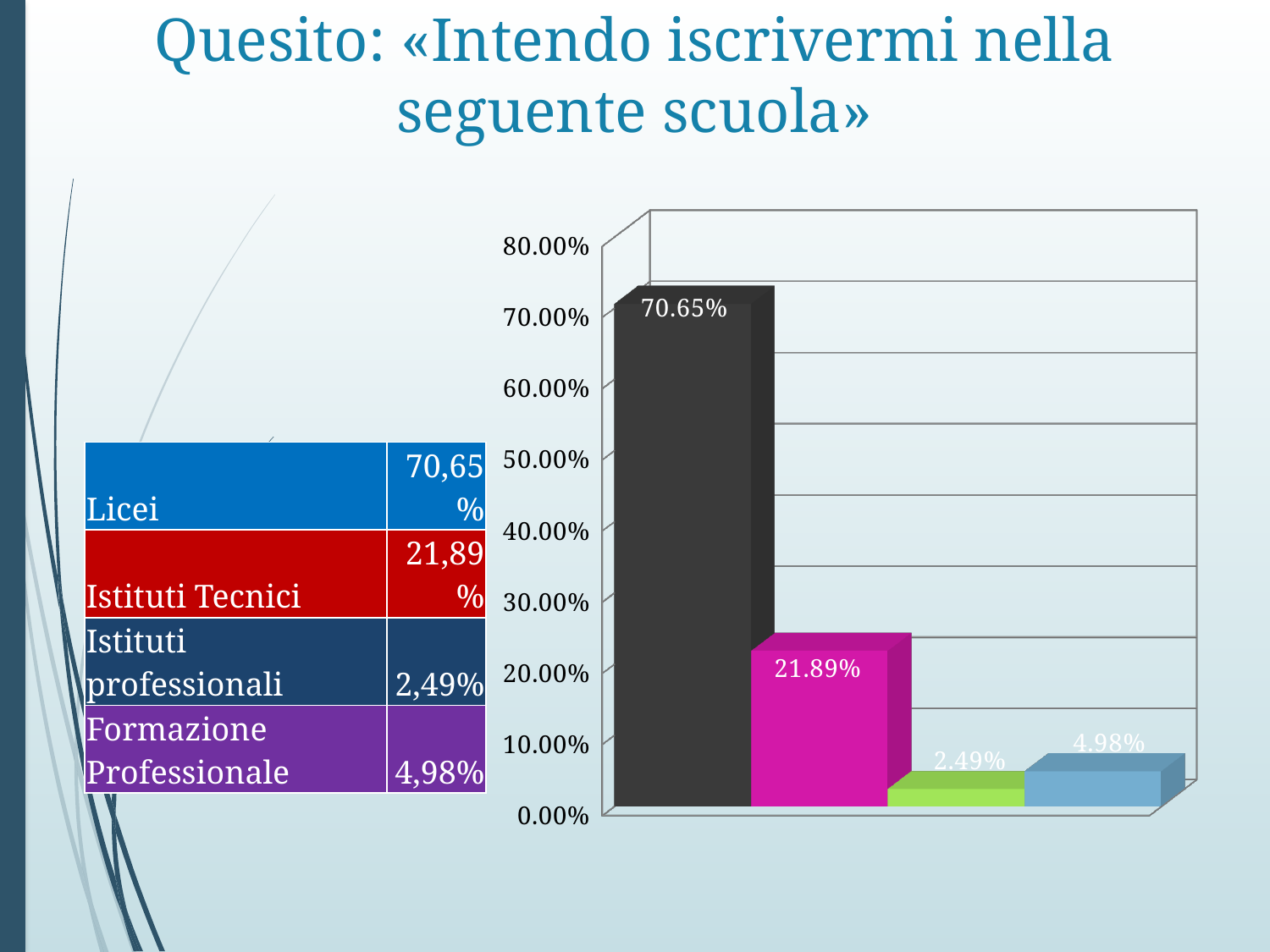
According to the table on the slide, what percentage intends to enrol in Istituti Tecnici? 21,89% Which is larger in the chart: the third bar (2.49%) or the fourth bar (4.98%)? the fourth bar (4.98%) What is the difference between the first bar (70.65%) and the second bar (21.89%) in the chart? 48.76% What is the data label on the second bar from the left in the chart? 21.89% What is the data label on the rightmost bar in the chart? 4.98% What is the value shown on the shortest bar in the chart? 2.49% According to the table on the slide, what percentage intends to enrol in Licei? 70,65% What is the highest value shown on the vertical axis of the chart? 80.00% What kind of chart is shown on the slide? bar chart Is the value of the tallest bar in the chart greater or less than 70.00%? greater How many bars are plotted in the chart? 4 What is the value shown on the tallest bar in the chart? 70.65%